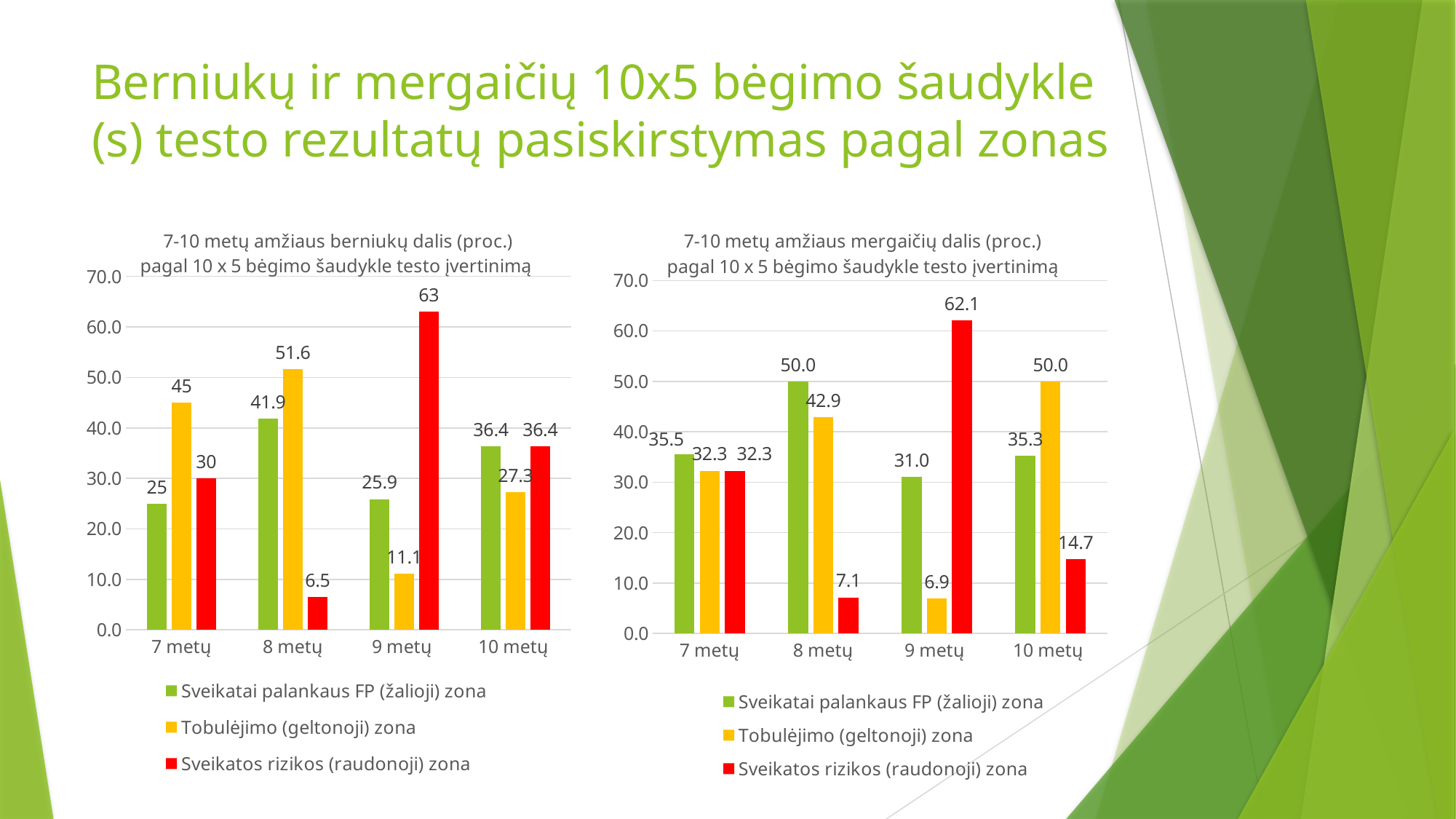
In the right chart (girls), what is the value of the Tobulėjimo (geltonoji) zona series for 10 metų? 50.0 How many age groups are shown on the x axis of the left chart (boys)? 4 In the right chart (girls), what is the difference between the Sveikatos rizikos (raudonoji) zona value for 9 metų and for 8 metų? 55.0 In the left chart (boys), which age group has the lowest value for the Tobulėjimo (geltonoji) zona series? 9 metų In the right chart (girls), what colour represents the Sveikatos rizikos (raudonoji) zona series? Red What type of chart is the left chart (boys)? Bar chart In the left chart (boys), what is the value of the Sveikatai palankaus FP (žalioji) zona series for 8 metų? 41.9 In the right chart (girls), which is larger for 8 metų: the Sveikatai palankaus FP (žalioji) zona value or the Tobulėjimo (geltonoji) zona value? Sveikatai palankaus FP (žalioji) zona In the right chart (girls), which age group has the highest value for the Sveikatos rizikos (raudonoji) zona series? 9 metų In the left chart (boys), what is the value of the Sveikatos rizikos (raudonoji) zona series for 9 metų? 63 In the left chart (boys), what is the difference between the Tobulėjimo (geltonoji) zona value and the Sveikatai palankaus FP (žalioji) zona value for 7 metų? 20 How many series does the legend of the right chart (girls) list? 3